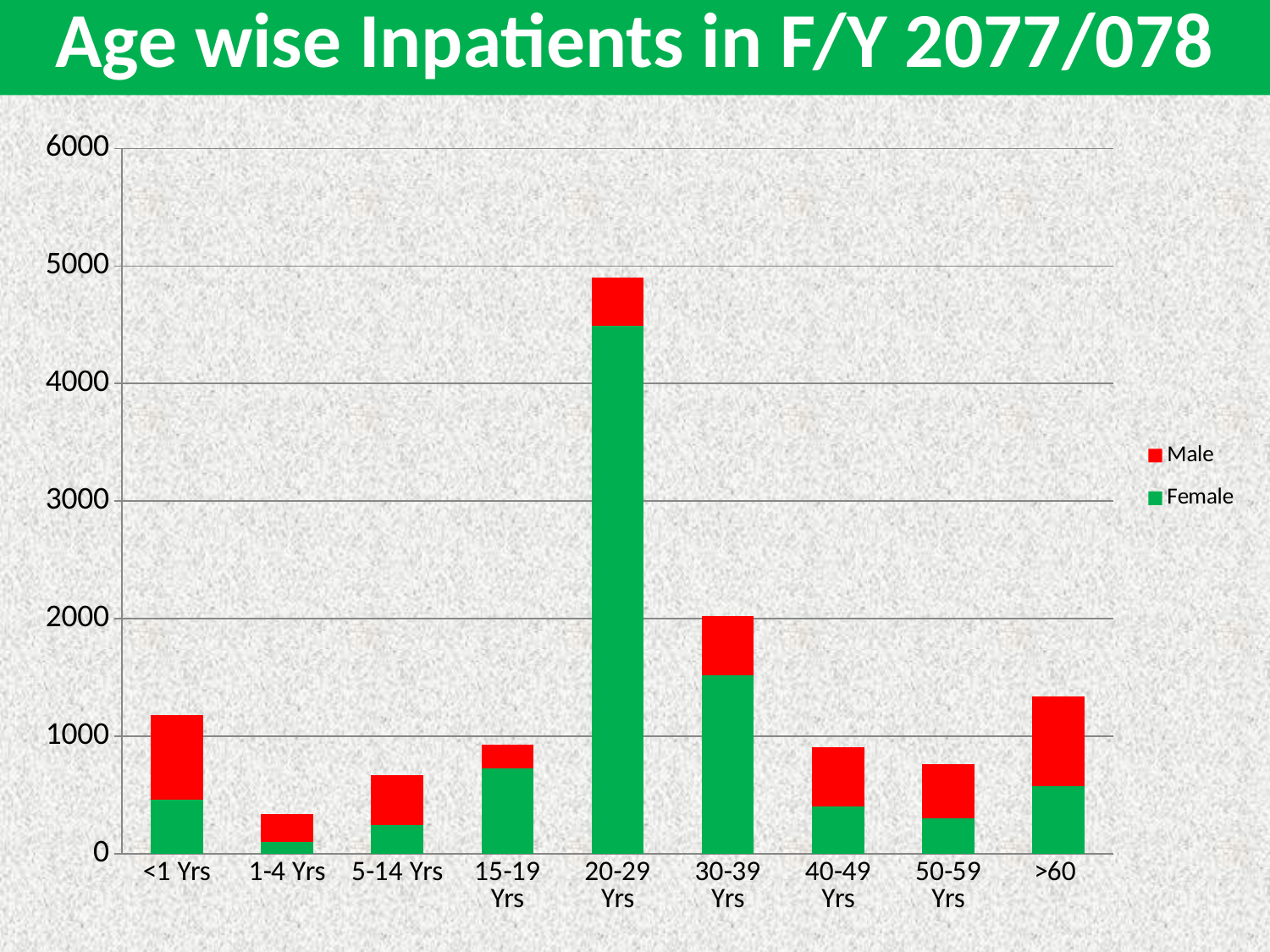
Is the total value for 1-4 Yrs greater or less than 1000? less Which has the larger Female value, 15-19 Yrs or 5-14 Yrs? 15-19 Yrs Which age group has the highest total number of inpatients? 20-29 Yrs Which age group has the lowest total number of inpatients? 1-4 Yrs Is the Female value for 20-29 Yrs greater or less than 4000? greater Which has the larger total number of inpatients, >60 or 50-59 Yrs? >60 How many series does the legend list? 2 What kind of chart is shown on the slide? Stacked bar chart Is the total value for 20-29 Yrs greater or less than 4000? greater What colour represents the Male series in the chart? Red How many age groups are shown on the x axis? 9